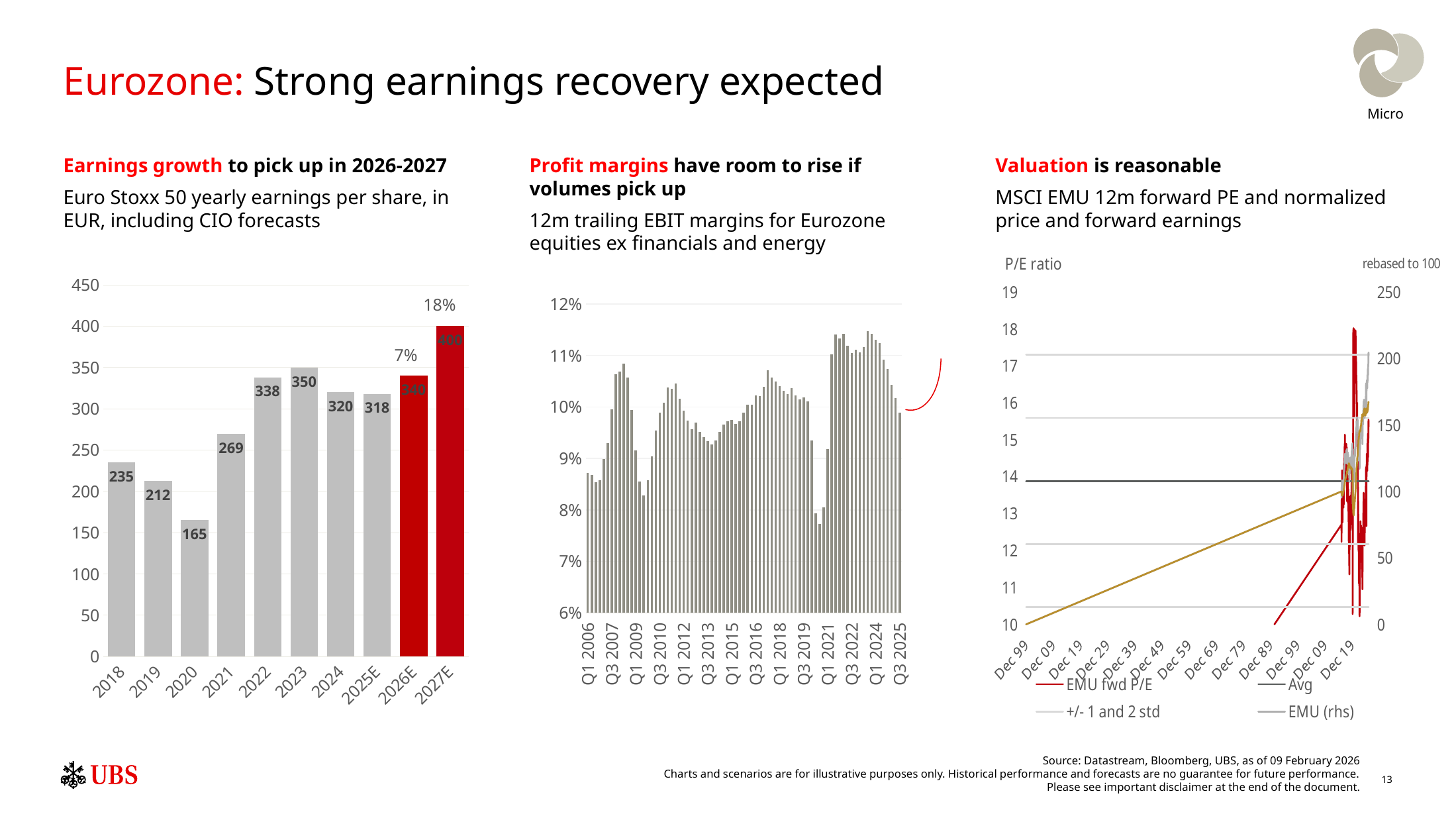
In the left chart (Euro Stoxx 50 yearly earnings per share), how many years are shown on the x axis? 10 In the left chart (Euro Stoxx 50 yearly earnings per share), which is larger, the value for 2024 or the value for 2025E? 2024 In the middle chart (12m trailing EBIT margins), is the value for Q1 2006 greater or less than 8%? greater In the left chart (Euro Stoxx 50 yearly earnings per share), what growth percentage is shown above the 2027E bar? 18% In the left chart (Euro Stoxx 50 yearly earnings per share), which year has the highest earnings per share? 2027E What kind of chart is the middle chart (12m trailing EBIT margins)? bar chart In the left chart (Euro Stoxx 50 yearly earnings per share), what is the difference between the 2027E and 2026E values? 60 In the left chart (Euro Stoxx 50 yearly earnings per share), what is the value for 2027E? 400 In the left chart (Euro Stoxx 50 yearly earnings per share), what is the value for 2023? 350 In the left chart (Euro Stoxx 50 yearly earnings per share), which year has the lowest earnings per share? 2020 How many series does the legend of the right chart (MSCI EMU 12m forward PE) list? 4